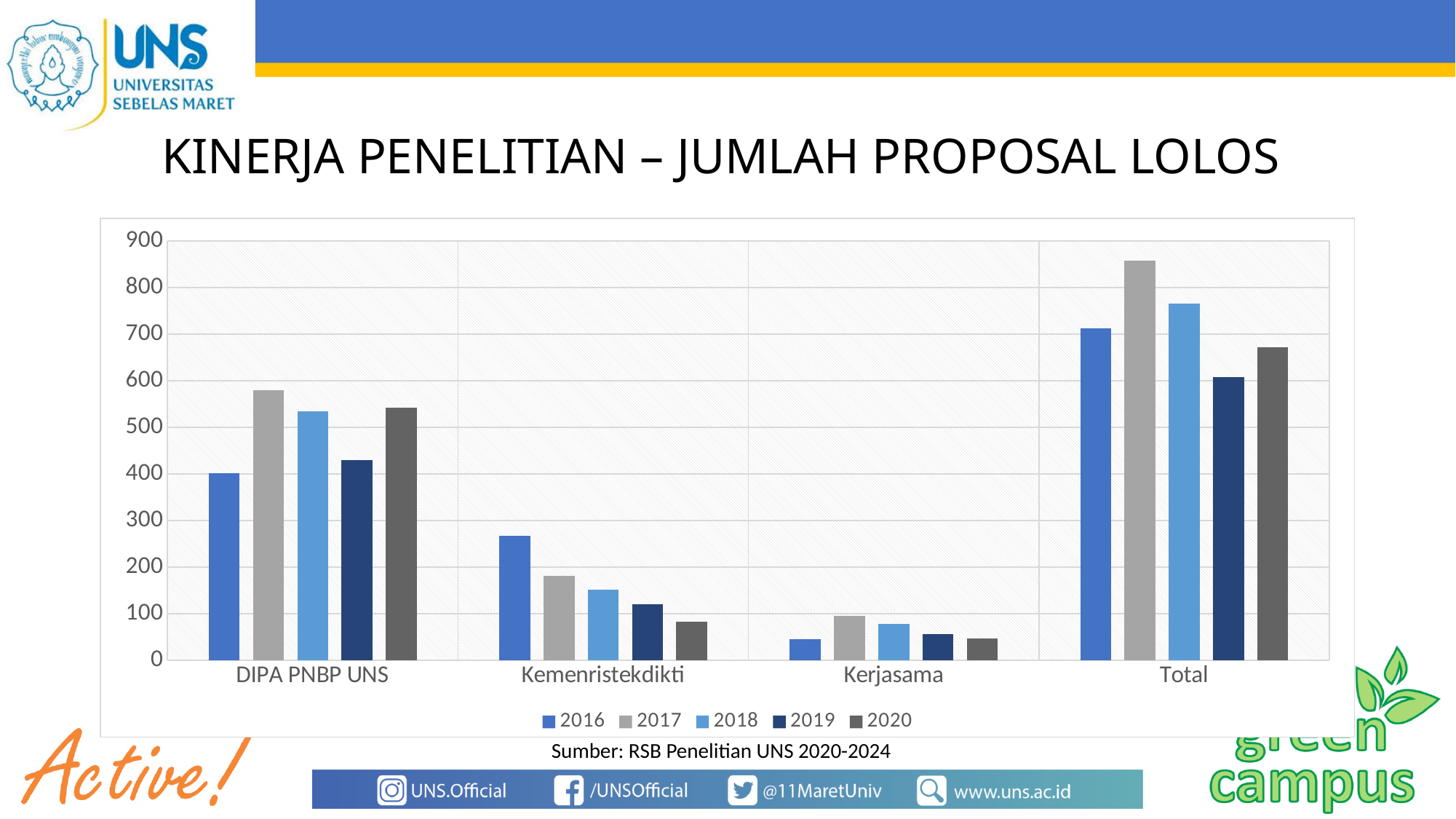
Do the values for Kemenristekdikti rise or fall from 2016 to 2020? fall What kind of chart is shown on the slide? Bar chart How many series does the legend list? 5 Which year has the highest value in the Total category? 2017 In the Kemenristekdikti category, which is larger: the value for 2016 or the value for 2017? 2016 Which year has the lowest value in the Kemenristekdikti category? 2020 Which year has the highest value in the Kerjasama category? 2017 Is the value for 2017 in Total greater or less than 800? greater Is the value for 2019 in Total greater or less than 700? less How many categories are shown on the x axis? 4 Which year has the highest value in the DIPA PNBP UNS category? 2017 Is the value for 2016 in DIPA PNBP UNS greater or less than 500? less